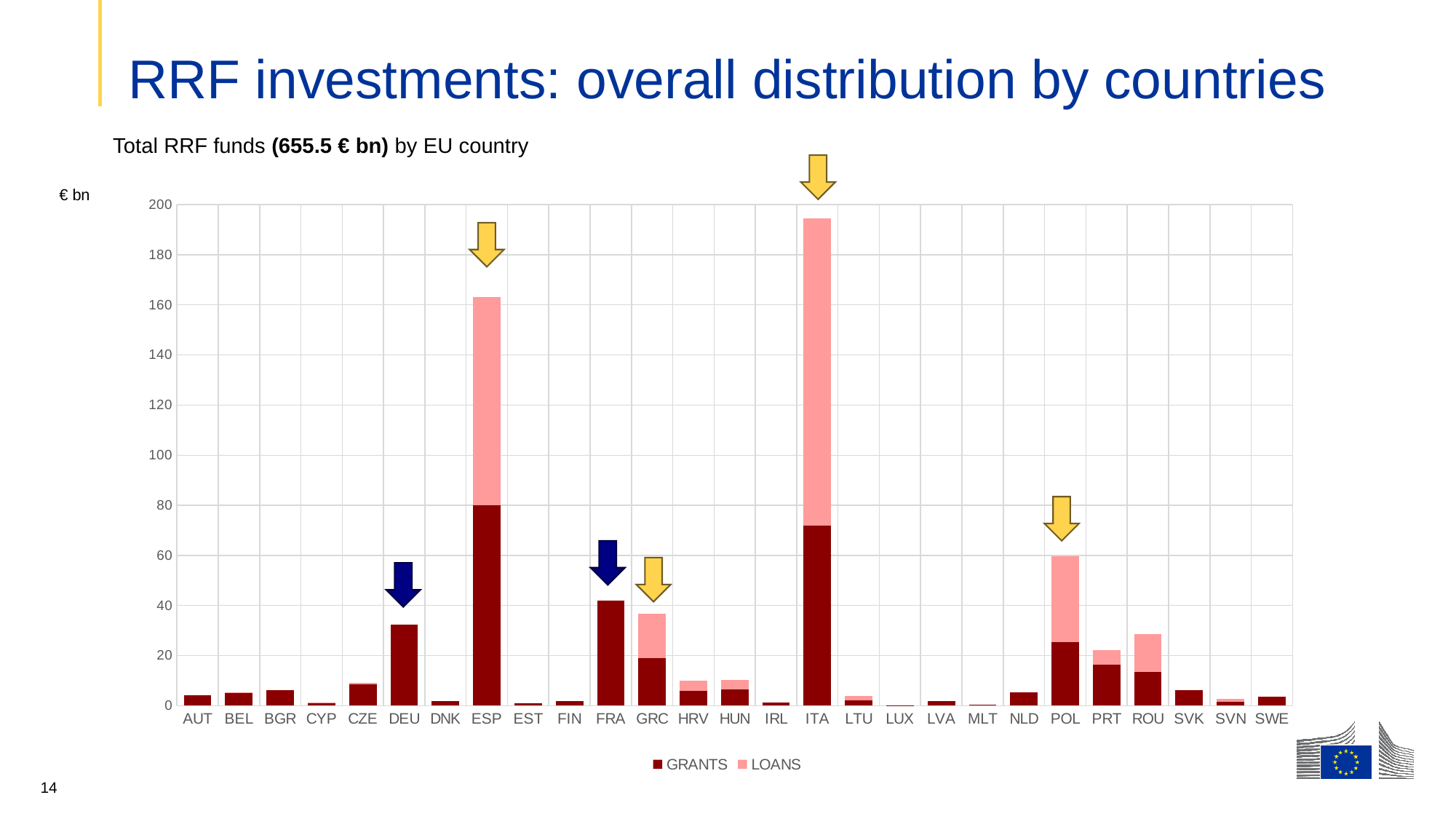
How many series does the chart's legend list? 2 Which has the larger total bar, DEU or FRA? FRA Is the total value for ITA greater or less than 180? greater Which has the larger total bar, ESP or ITA? ITA What kind of chart is shown on the slide? Stacked bar chart Which country has the highest total bar in the chart? ITA Is the total value for FRA greater or less than 60? less Is the total value for DEU greater or less than 40? less Which has the larger total bar, POL or ROU? POL What are the two series named in the chart's legend? GRANTS and LOANS How many countries are shown on the x axis of the chart? 27